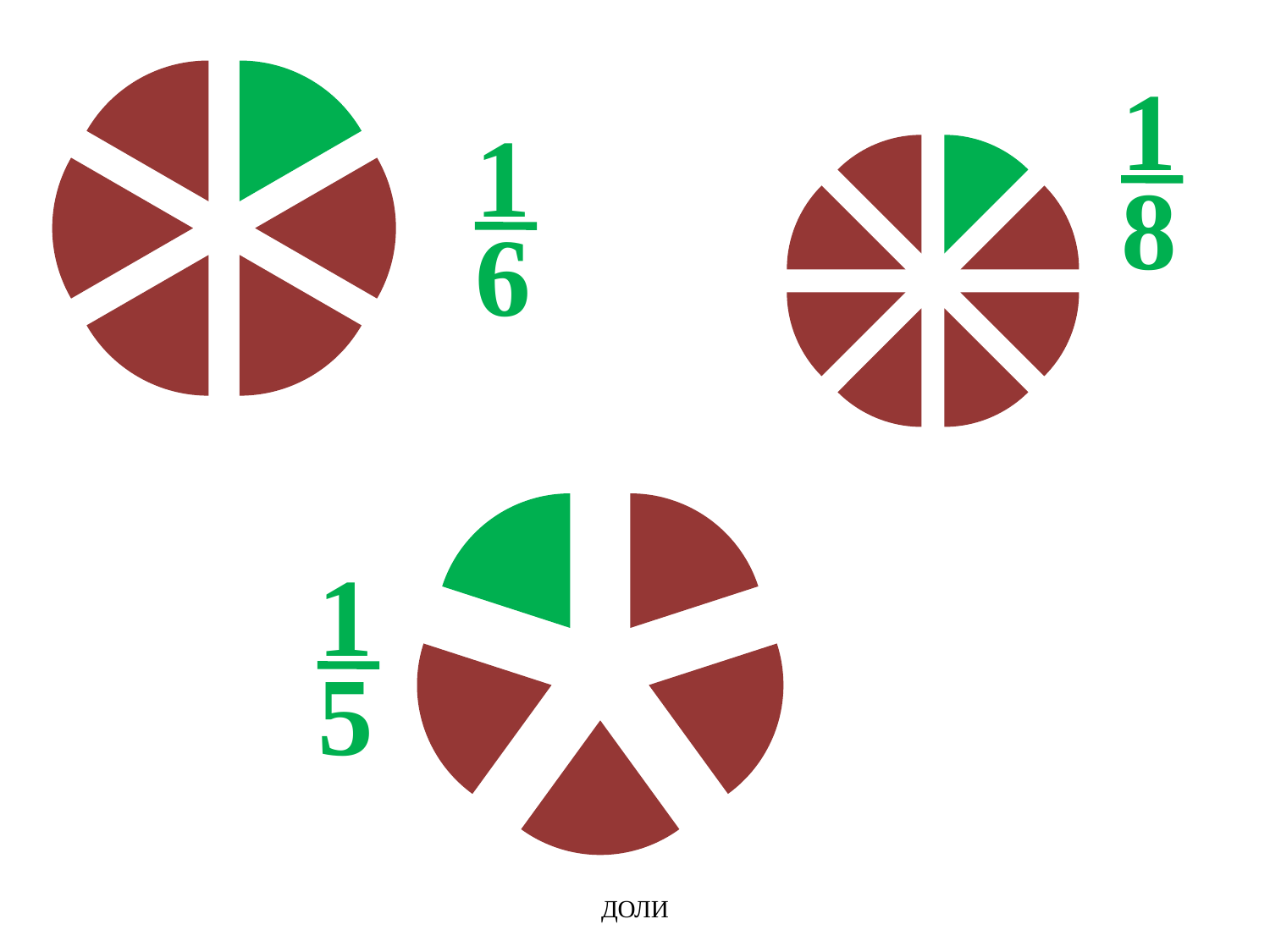
What kind of chart is the top-left chart? pie chart What word is written at the bottom of the slide? доли What share of the top-left pie chart does the green slice represent? 1/6 Is the green slice of the top-left pie chart larger or smaller than the green slice of the top-right pie chart? larger What share of the bottom pie chart does the green slice represent? 1/5 Which pie chart on the slide is divided into the most slices? the top-right chart How many slices does the top-left pie chart have? 6 How many slices does the bottom pie chart have? 5 How many green slices does the bottom pie chart have? 1 What share of the top-right pie chart does the green slice represent? 1/8 Which pie chart on the slide is divided into the fewest slices? the bottom chart